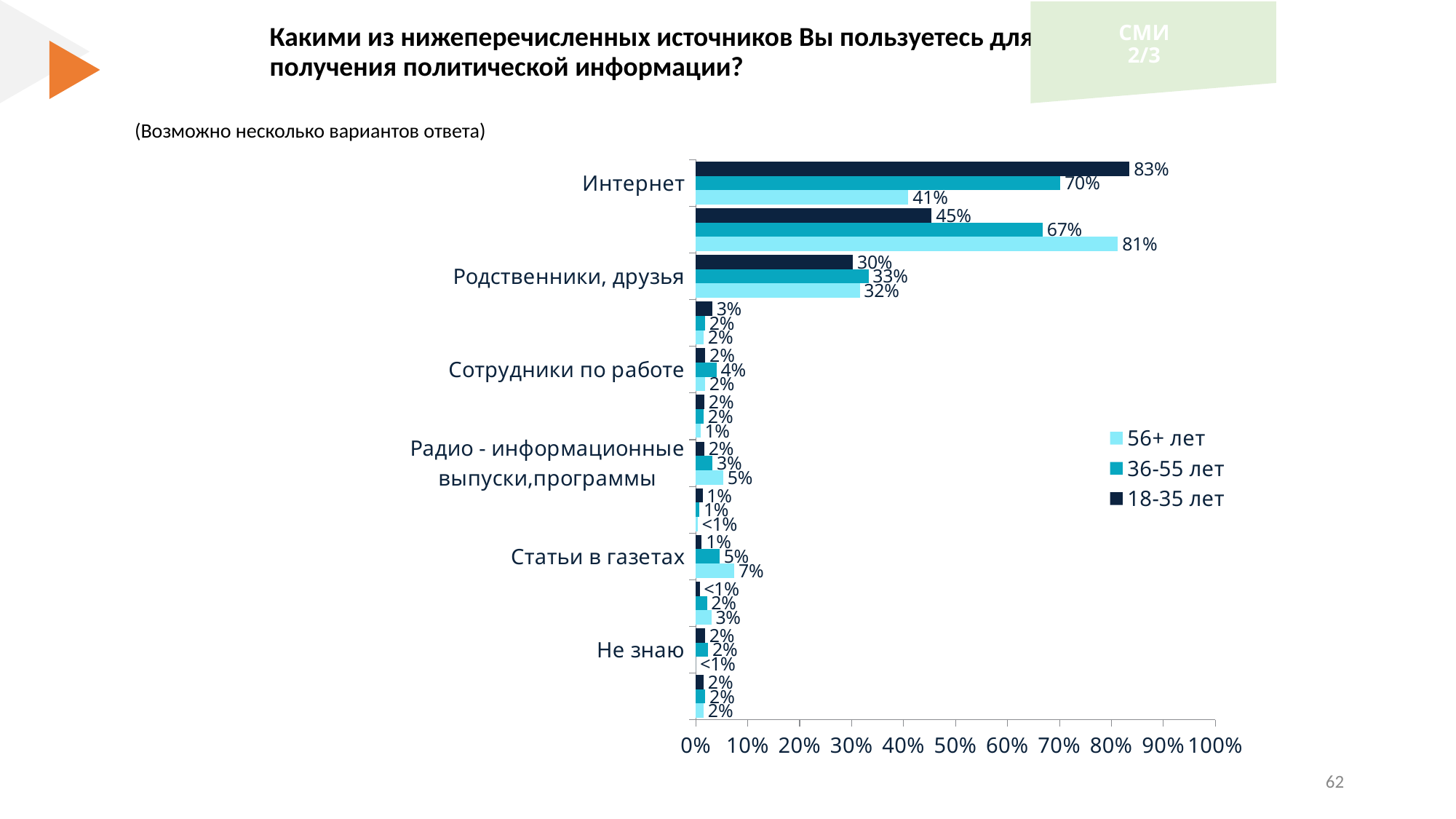
How many series does the legend list? 3 Is the value for Интернет for the 18-35 лет series greater or less than 80%? greater What is the difference between the 18-35 лет and 56+ лет values for Интернет? 42% What kind of chart is shown on the slide? Bar chart What is the value for Родственники, друзья for the 36-55 лет series? 33% What is the value for Интернет for the 56+ лет series? 41% For Интернет, which is larger: the 36-55 лет value or the 56+ лет value? 36-55 лет For Интернет, which age group has the highest value? 18-35 лет What is the value for Интернет for the 18-35 лет series? 83% What is the value for Статьи в газетах for the 56+ лет series? 7% For Статьи в газетах, which age group has the lowest value? 18-35 лет What is the value for Сотрудники по работе for the 36-55 лет series? 4%